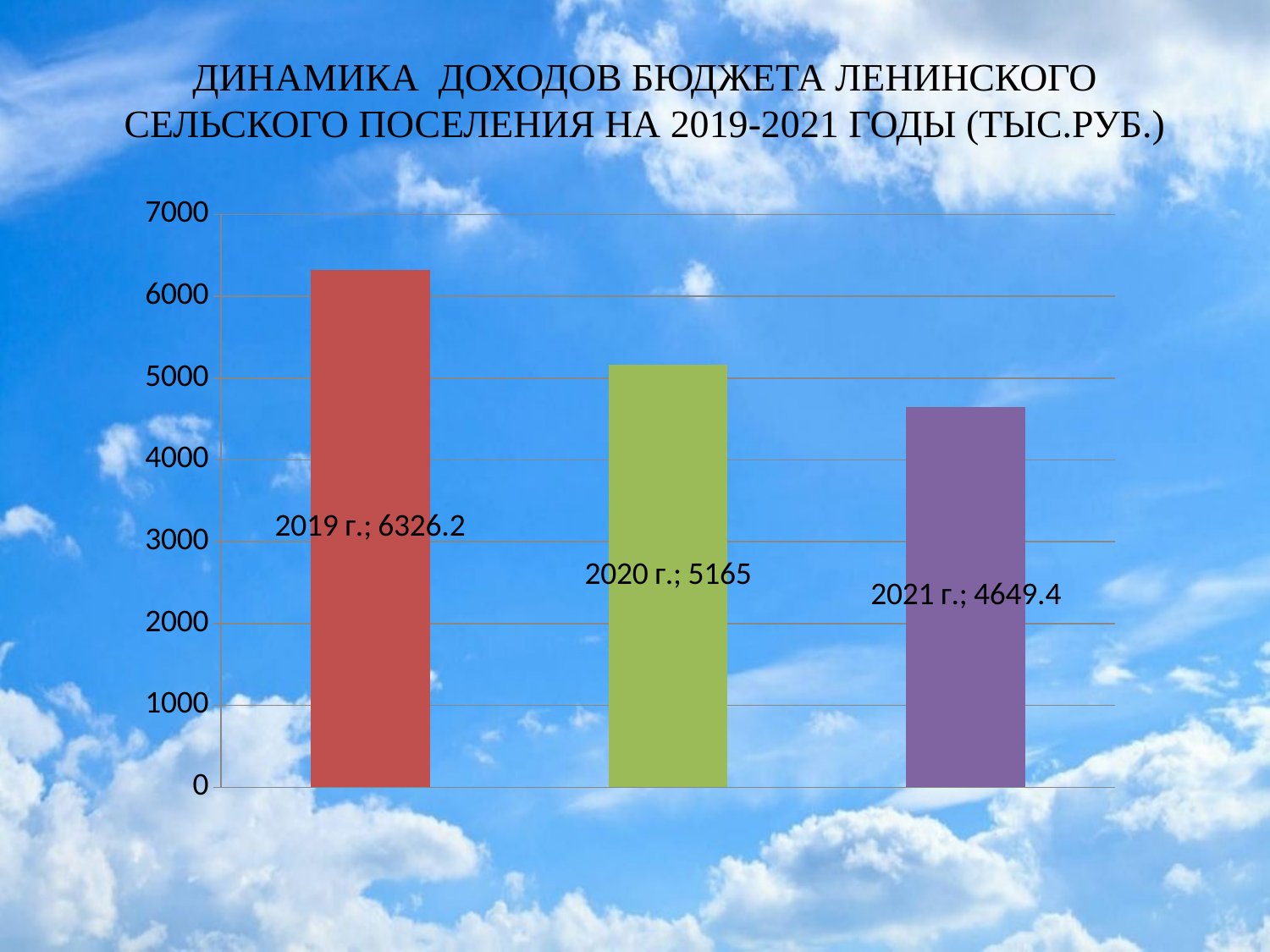
How many years are shown in the chart? 3 What is the difference between the values for 2019 г. and 2020 г.? 1161.2 Do the values rise or fall from 2019 г. to 2021 г.? fall Which is larger, the value for 2020 г. or the value for 2021 г.? 2020 г. Is the value for 2021 г. greater or less than 5000? less Which year has the lowest budget income? 2021 г. What is the budget income value for 2021 г.? 4649.4 Which year has the highest budget income? 2019 г. What is the budget income value for 2019 г.? 6326.2 What kind of chart is shown on the slide? bar chart What is the difference between the values for 2020 г. and 2021 г.? 515.6 What is the budget income value for 2020 г.? 5165